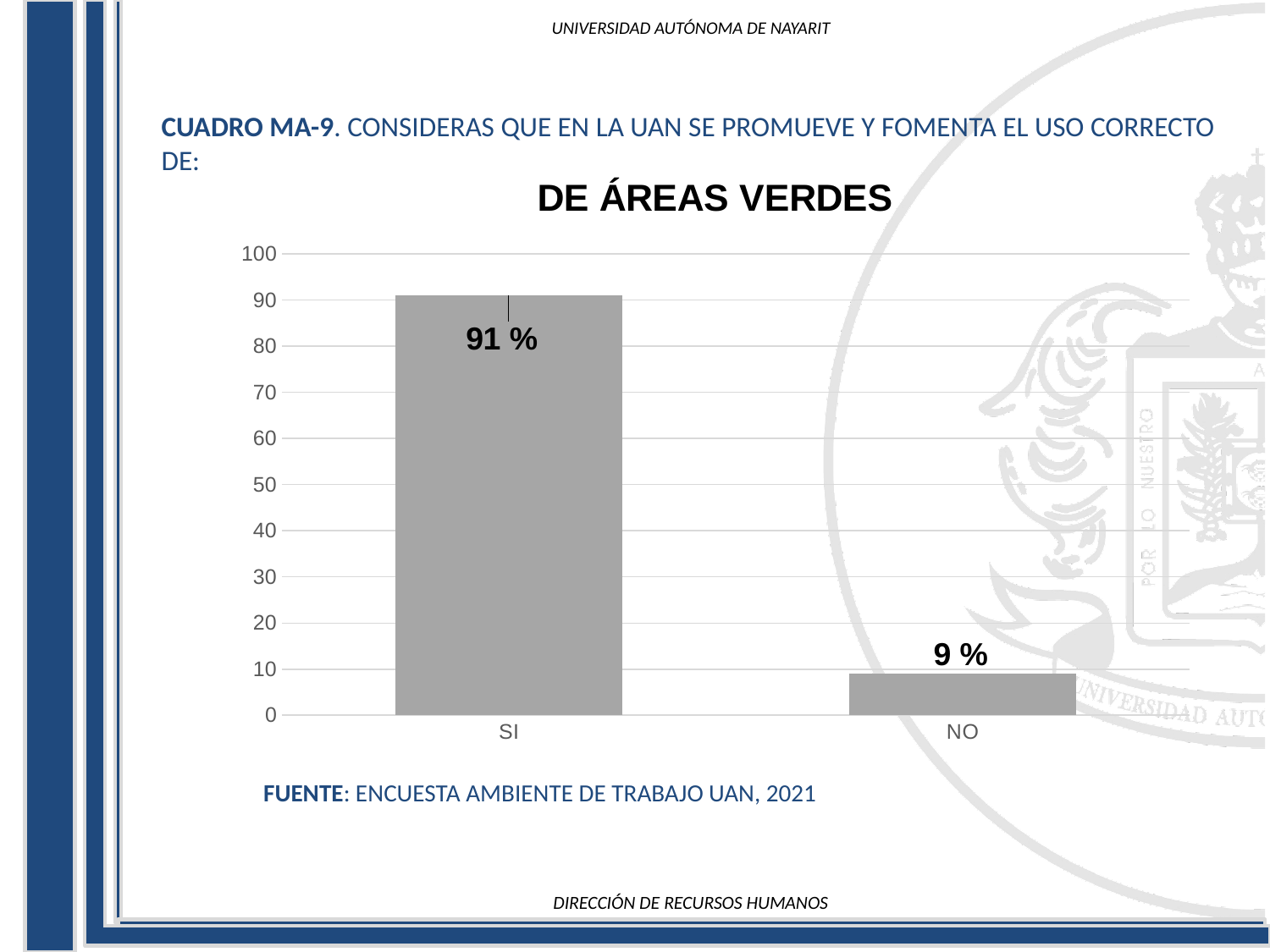
What kind of chart is shown? bar chart Is the value for NO greater or less than 20? less How many categories are shown on the x axis? 2 Which is larger, the value for SI or the value for NO? SI What is the value for NO? 9 % What is the value for SI? 91 % Which category has the highest value? SI Is the value for SI greater or less than 80? greater What is the difference between the values for SI and NO? 82 % Which category has the lowest value? NO What is the title of the chart? DE ÁREAS VERDES What is the highest value shown on the y axis? 100